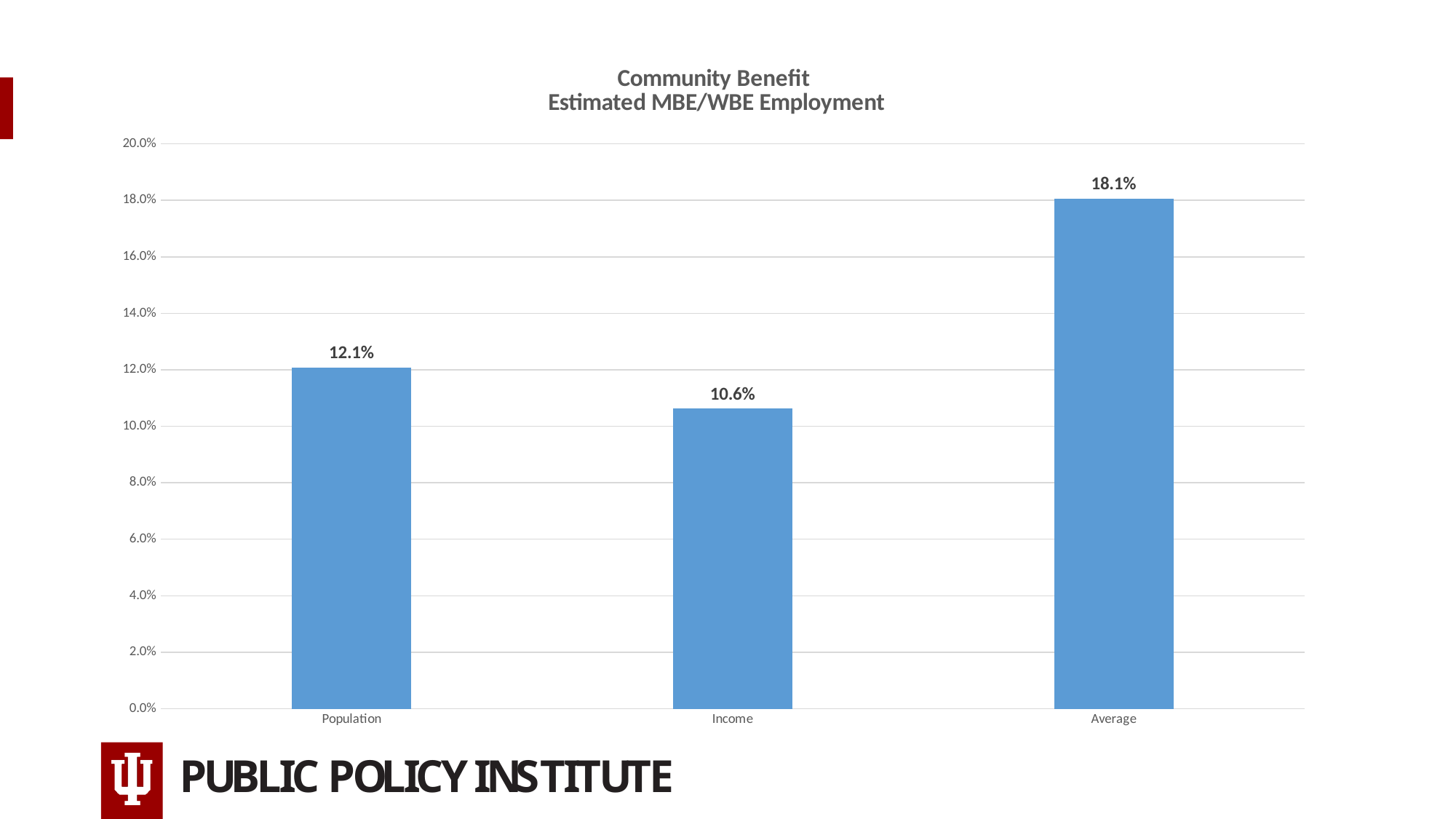
Is the value for Average greater or less than 16.0%? greater What is the difference between the values for Average and Population? 6.0% What is the title of the chart? Community Benefit Estimated MBE/WBE Employment Which category has the lowest value? Income Which category has the highest value? Average How many categories are shown on the x axis? 3 What kind of chart is shown on the slide? bar chart What is the value for Average? 18.1% Which is larger, the value for Population or the value for Income? Population What is the value for Population? 12.1% What is the difference between the values for Population and Income? 1.5% What is the value for Income? 10.6%